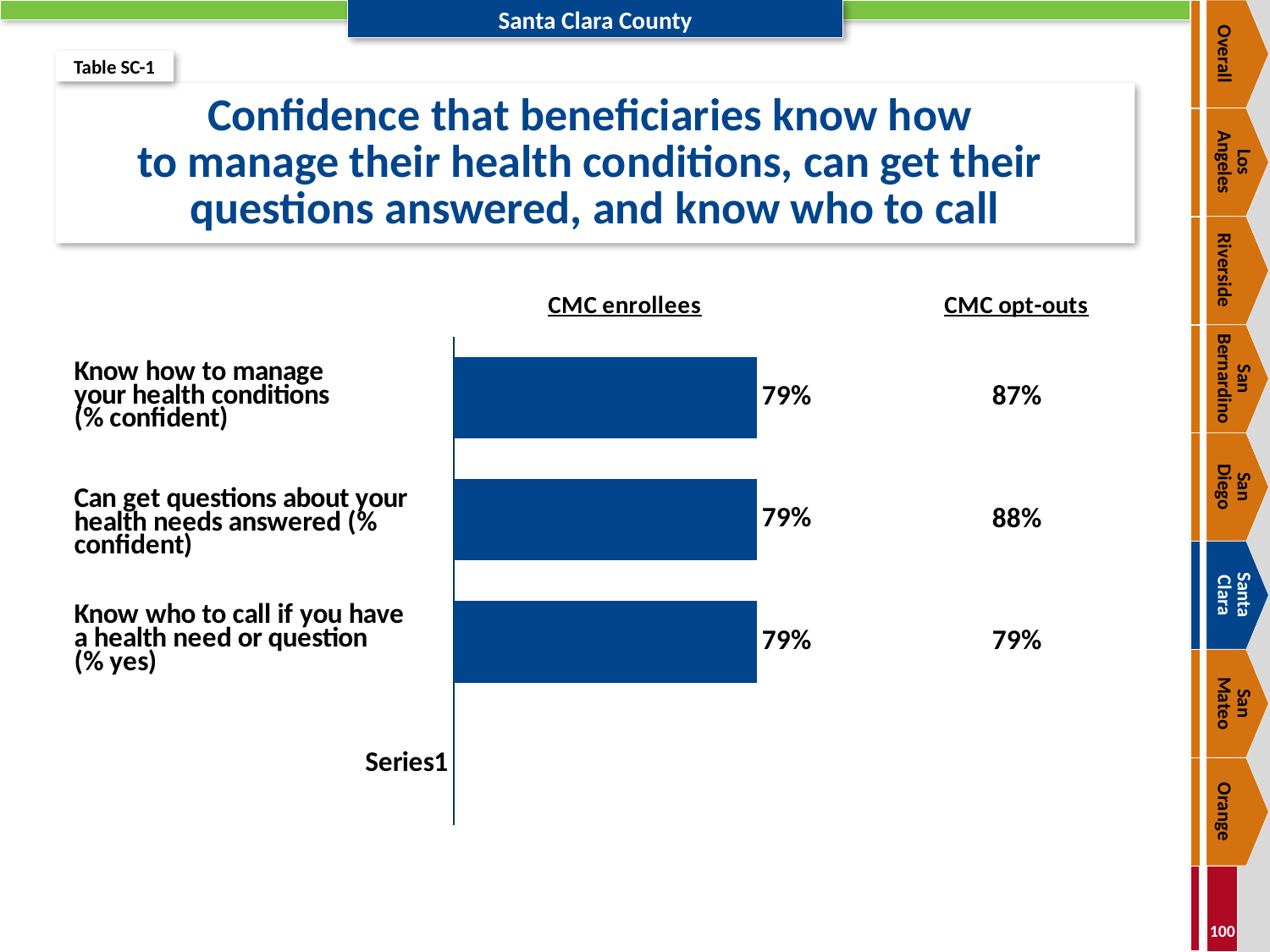
What is the CMC enrollees value for "Can get questions about your health needs answered (% confident)"? 79% What is the difference between the CMC opt-outs and CMC enrollees values for "Know how to manage your health conditions (% confident)"? 8% What is the title of the chart on the slide? Confidence that beneficiaries know how to manage their health conditions, can get their questions answered, and know who to call What is the CMC enrollees value for "Know how to manage your health conditions (% confident)"? 79% What kind of chart is shown on the slide? bar chart What is the CMC opt-outs value for "Can get questions about your health needs answered (% confident)"? 88% How many bars are plotted in the chart? 3 What is the CMC enrollees value for "Know who to call if you have a health need or question (% yes)"? 79% What is the CMC opt-outs value for "Know how to manage your health conditions (% confident)"? 87% What is the CMC opt-outs value for "Know who to call if you have a health need or question (% yes)"? 79% What is the difference between the CMC opt-outs and CMC enrollees values for "Can get questions about your health needs answered (% confident)"? 9% For "Know how to manage your health conditions (% confident)", which group has the higher value, CMC enrollees or CMC opt-outs? CMC opt-outs